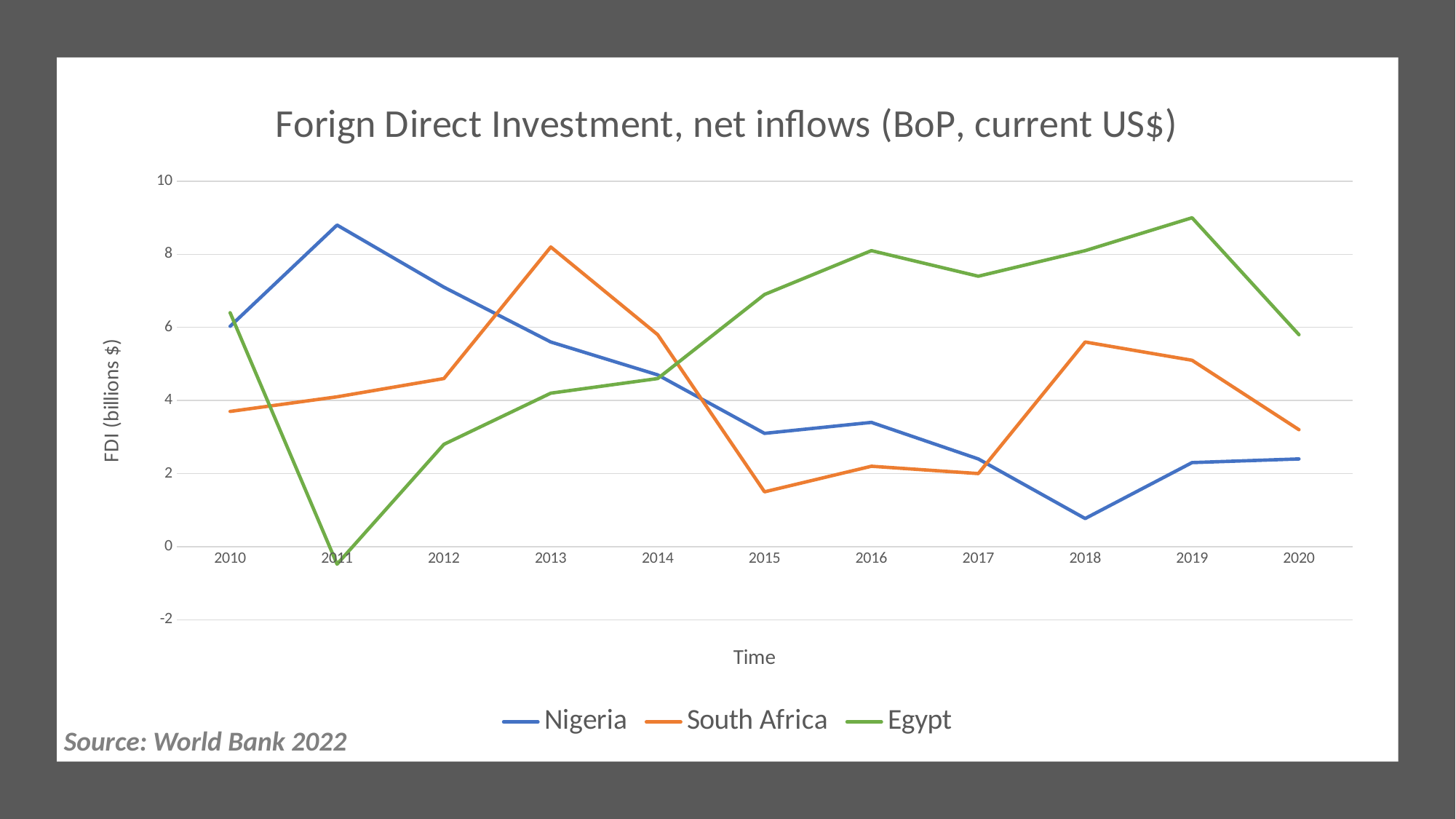
In which year does Nigeria reach its highest FDI value? 2011 Is the value for South Africa in 2015 greater or less than 2? less In which year does Egypt have its lowest FDI value? 2011 In 2013, which has the larger FDI value, South Africa or Nigeria? South Africa Is the value for Nigeria in 2011 greater or less than 8? greater Does Egypt's FDI rise or fall from 2012 to 2016? Rise How many years are plotted along the x axis? 11 Is the value for Egypt in 2011 greater or less than 0? less In which year does Egypt reach its highest FDI value? 2019 In which year does Nigeria have its lowest FDI value? 2018 How many series does the legend list? 3 What type of chart is shown on the slide? Line chart